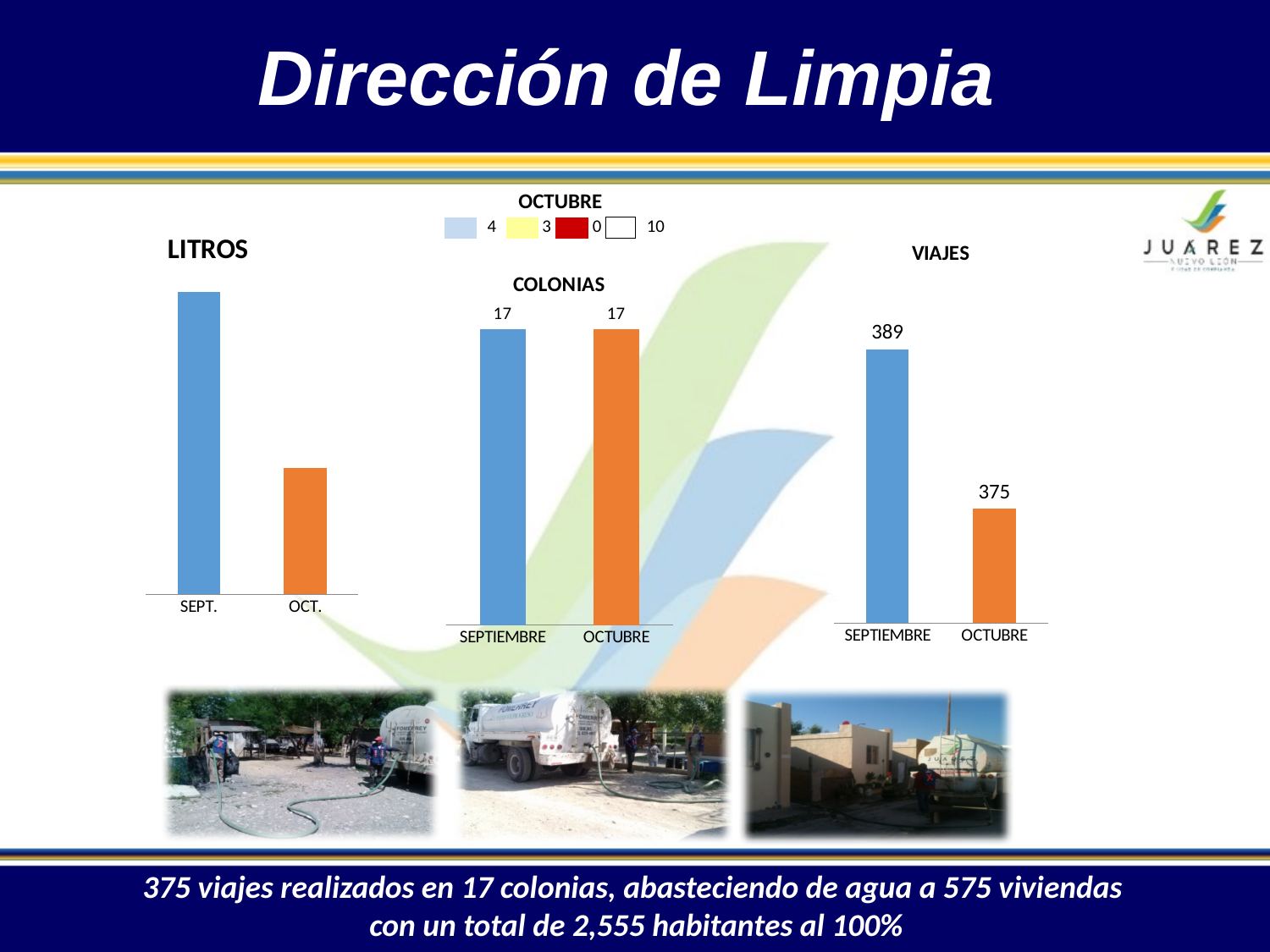
In the COLONIAS chart, what is the value for OCTUBRE? 17 What kind of chart is the VIAJES chart? bar chart In the LITROS chart, do the values rise or fall from SEPT. to OCT.? fall In the VIAJES chart, what is the value for SEPTIEMBRE? 389 In the VIAJES chart, which month has the lowest value? OCTUBRE How many categories are shown in the COLONIAS chart? 2 In the LITROS chart, which is larger, the bar for SEPT. or the bar for OCT.? SEPT. In the VIAJES chart, which month has the highest value? SEPTIEMBRE In the VIAJES chart, what is the difference between the SEPTIEMBRE and OCTUBRE values? 14 In the VIAJES chart, what is the value for OCTUBRE? 375 In the COLONIAS chart, what is the value for SEPTIEMBRE? 17 In the COLONIAS chart, what is the difference between the SEPTIEMBRE and OCTUBRE values? 0